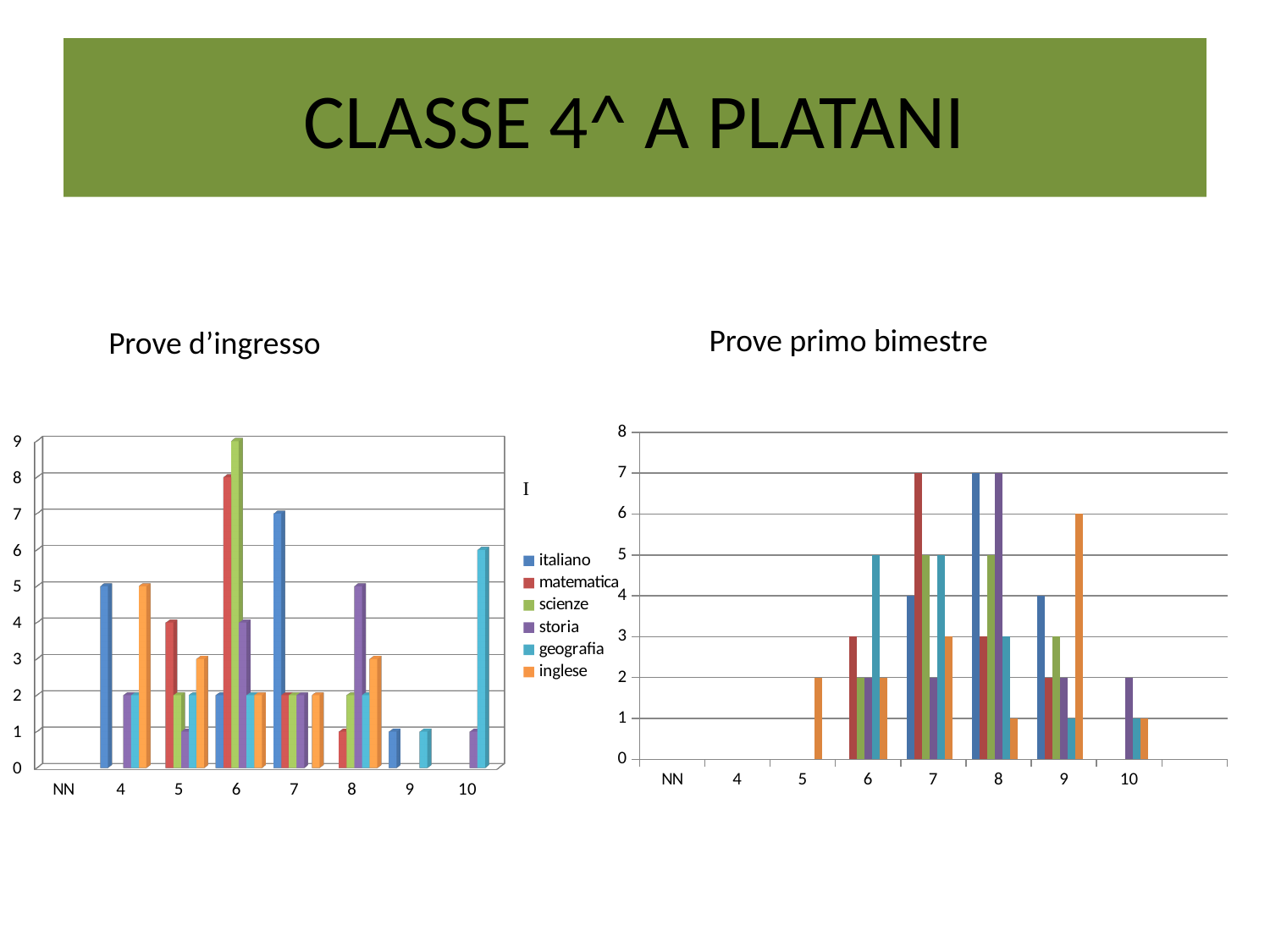
In the 'Prove primo bimestre' chart, which is larger: italiano at category 8 or italiano at category 9? italiano at category 8 What kind of chart is the 'Prove d’ingresso' chart on the left? bar chart In the 'Prove primo bimestre' chart, at which category is the inglese bar highest? 9 In the 'Prove primo bimestre' chart, what is the value for inglese at category 9? 6 In the 'Prove d’ingresso' chart, is the value for scienze at category 6 greater or less than 8? greater How many series does the legend list? 6 In the 'Prove primo bimestre' chart, what is the difference between inglese at category 9 and inglese at category 8? 5 In the 'Prove primo bimestre' chart, what is the value for geografia at category 6? 5 In the 'Prove primo bimestre' chart, what is the value for matematica at category 7? 7 In the 'Prove primo bimestre' chart, how many categories are shown on the x axis? 8 What is the title of the chart on the right of the slide? Prove primo bimestre In the 'Prove d’ingresso' chart, is the value for geografia at category 10 greater or less than 5? greater